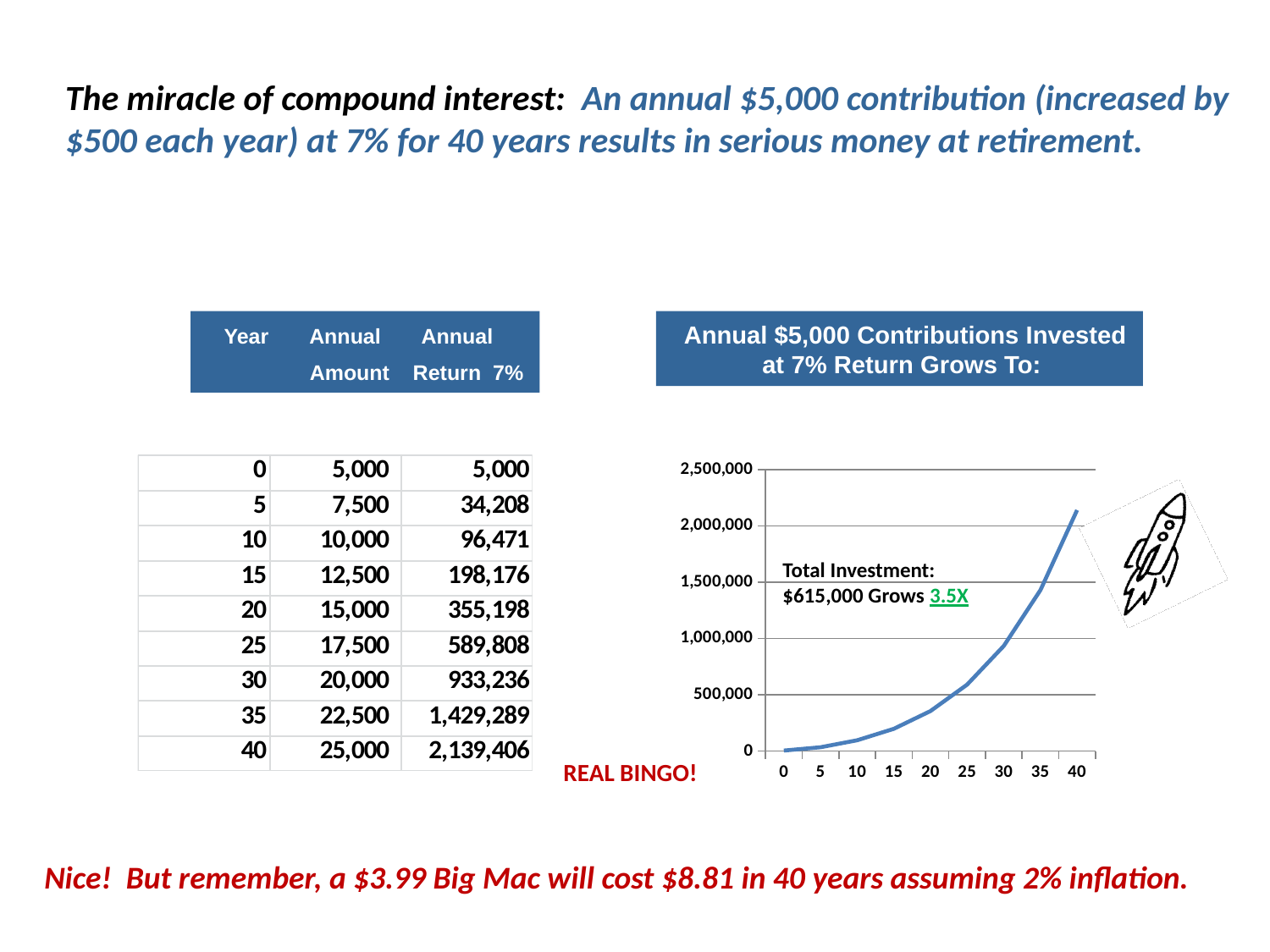
At which year on the x axis does the line reach its highest value? 40 Is the value at year 30 greater or less than 1,000,000? less What is the title of the chart? Annual $5,000 Contributions Invested at 7% Return Grows To: At which year on the x axis is the line at its lowest value? 0 Is the value at year 40 greater or less than 2,000,000? greater How many year labels are shown on the x axis of the chart? 9 Is the value at year 35 greater or less than 1,500,000? less Which is larger, the value at year 25 or the value at year 35? year 35 What kind of chart is shown on the slide? line chart What is the highest value labelled on the y axis of the chart? 2,500,000 Do the values on the chart rise or fall as the years increase along the x axis? rise